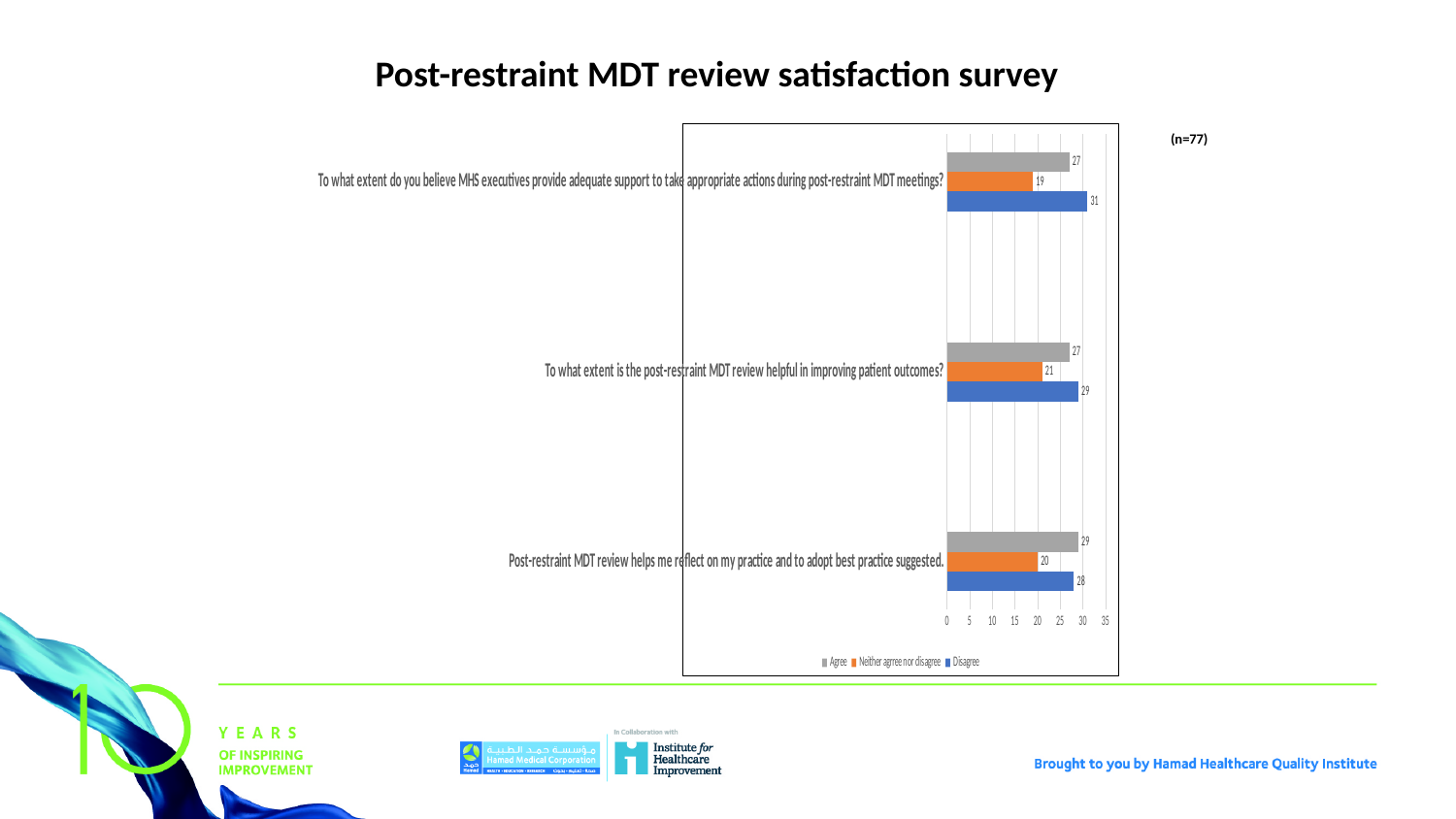
What is the difference between the Disagree and Neither agree nor disagree values for "To what extent do you believe MHS executives provide adequate support to take appropriate actions during post-restraint MDT meetings?" 12 How many series does the legend list? 3 What is the Neither agree nor disagree value for "To what extent is the post-restraint MDT review helpful in improving patient outcomes?" 21 Which survey statement has the lowest Neither agree nor disagree value? To what extent do you believe MHS executives provide adequate support to take appropriate actions during post-restraint MDT meetings? How many survey statements (categories) are plotted in the chart? 3 What is the Agree value for "Post-restraint MDT review helps me reflect on my practice and to adopt best practice suggested." 29 What kind of chart is shown on the slide? bar chart What is the Disagree value for "To what extent do you believe MHS executives provide adequate support to take appropriate actions during post-restraint MDT meetings?" 31 For "Post-restraint MDT review helps me reflect on my practice and to adopt best practice suggested.", which is larger: the Agree value or the Disagree value? Agree What colour represents the Disagree series in the chart? blue Which series has the highest value for "To what extent do you believe MHS executives provide adequate support to take appropriate actions during post-restraint MDT meetings?" Disagree What is the total of the three series for "To what extent is the post-restraint MDT review helpful in improving patient outcomes?" 77